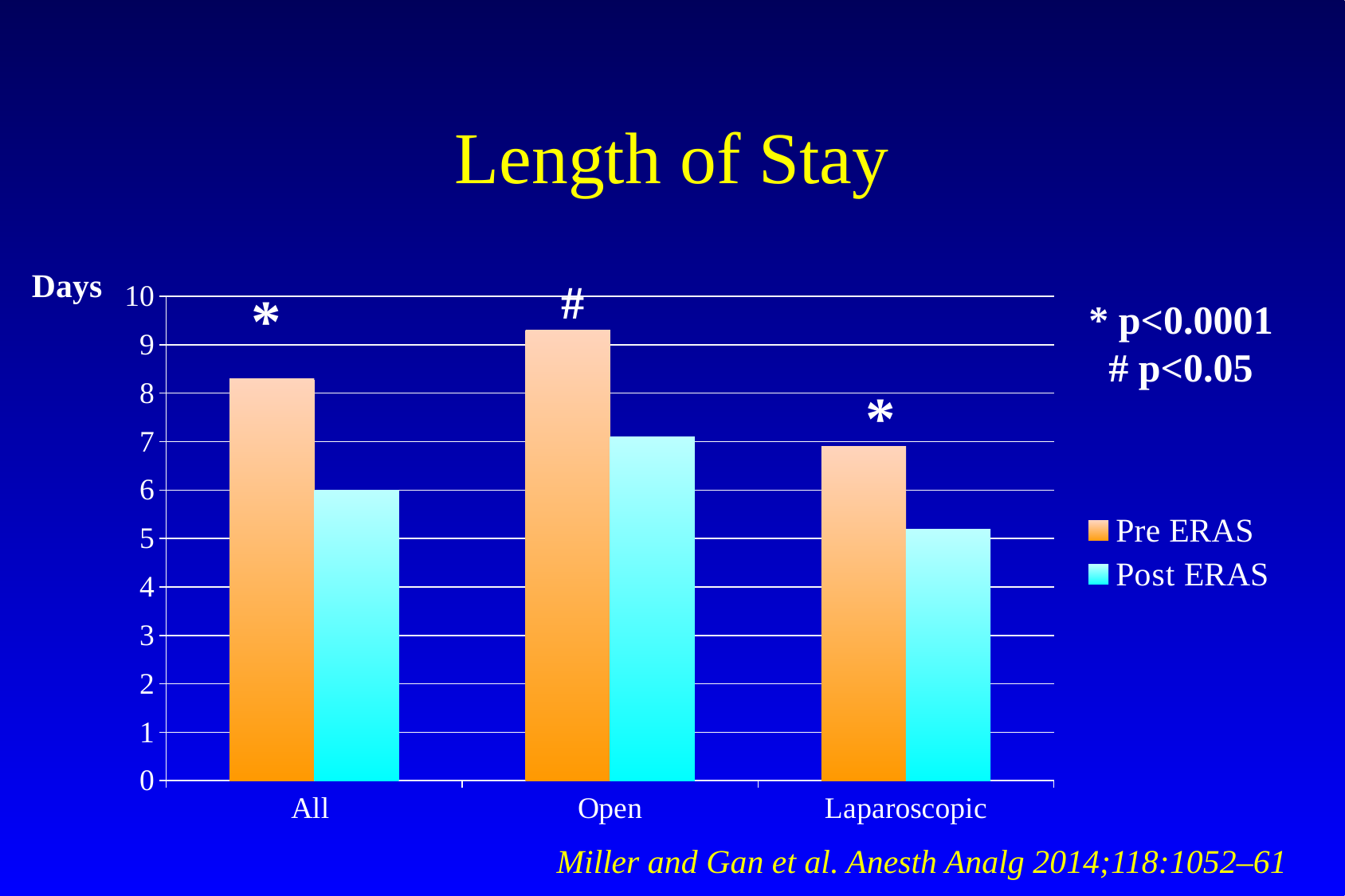
Is the Pre ERAS value for All greater or less than 8? greater Which category has the lowest Post ERAS length of stay? Laparoscopic What is the title of the chart? Length of Stay How many categories are shown on the x axis? 3 Which category has the lowest Pre ERAS length of stay? Laparoscopic What kind of chart is shown on the slide? bar chart Is the Pre ERAS value for Open greater or less than 9? greater Is the Post ERAS value for Laparoscopic greater or less than 6? less Which category has the highest Pre ERAS length of stay? Open How many series does the legend list? 2 For the Open category, which is larger: Pre ERAS or Post ERAS? Pre ERAS What unit is shown on the y axis label? Days